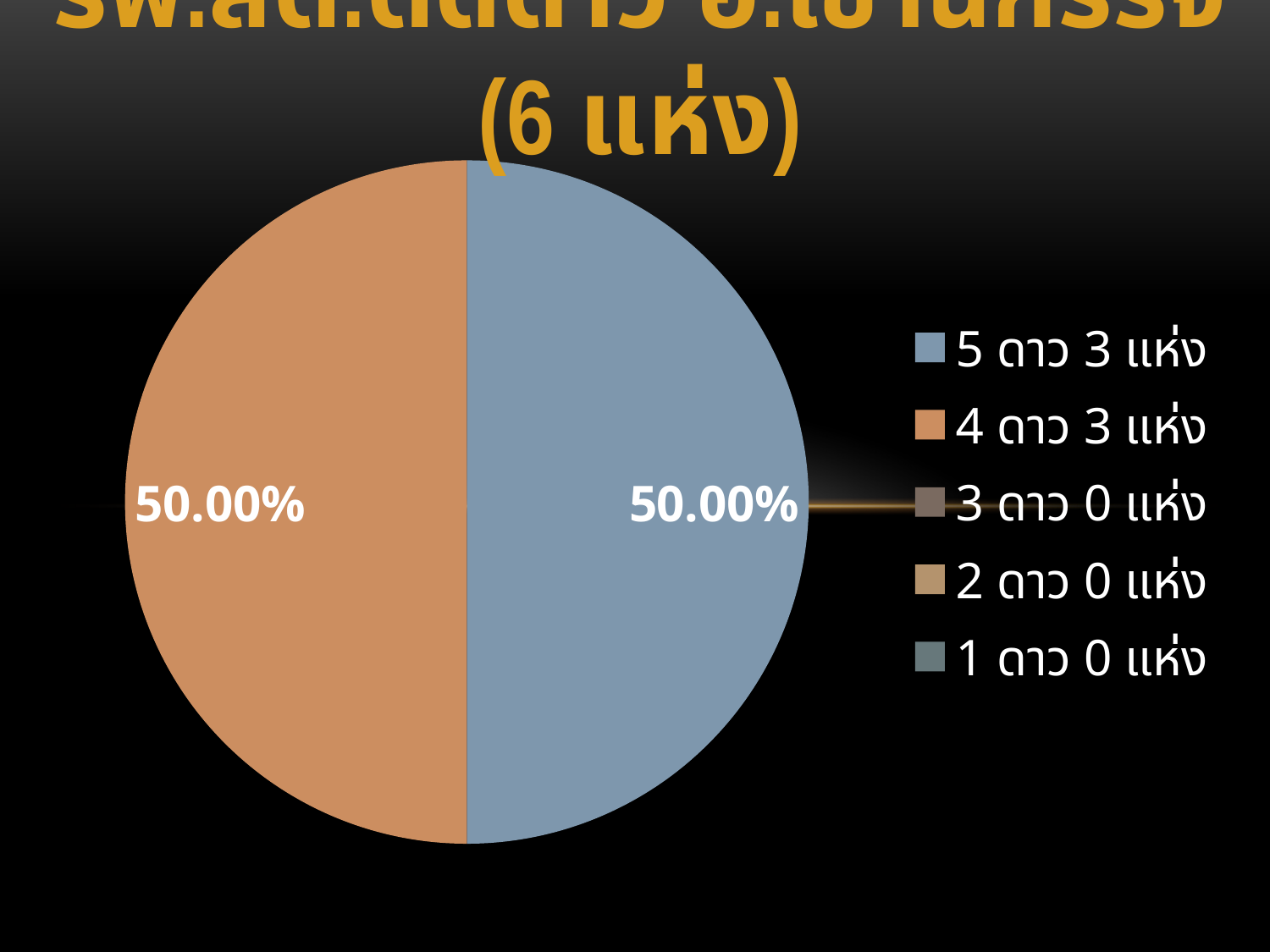
How many legend categories have 0 แห่ง? 3 What colour is the 4 ดาว slice of the pie? orange-brown What colour is the 5 ดาว slice of the pie? blue-grey What share of the pie does the 5 ดาว slice represent? 50.00% How many slices are visible in the pie chart? 2 What share of the pie does the 4 ดาว slice represent? 50.00% According to the legend, how many แห่ง are in the 3 ดาว category? 0 แห่ง According to the legend, how many แห่ง are in the 5 ดาว category? 3 แห่ง How many entries does the legend list? 5 According to the legend, how many แห่ง are in the 4 ดาว category? 3 แห่ง What kind of chart is shown on the slide? pie chart